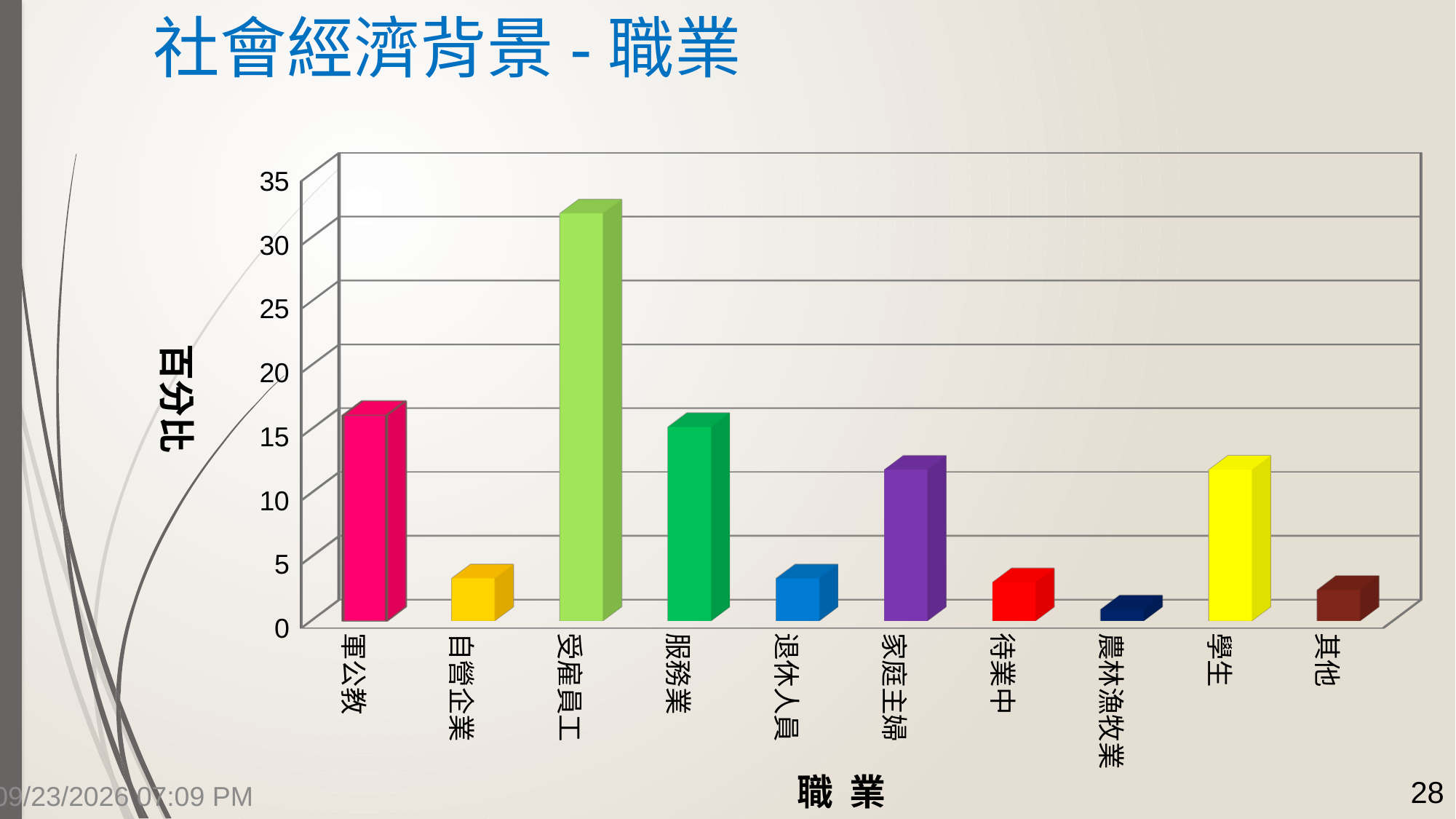
What kind of chart is shown on the slide? bar chart Is the value for 軍公教 greater or less than 10? greater Is the value for 學生 greater or less than 10? greater How many occupation categories are plotted on the x axis? 10 Which is larger, the value for 服務業 or the value for 家庭主婦? 服務業 Which is larger, the value for 受雇員工 or the value for 軍公教? 受雇員工 What is the title of the vertical axis? 百分比 Which occupation category has the lowest percentage? 農林漁牧業 Is the value for 服務業 greater or less than 20? less Which occupation category has the highest percentage? 受雇員工